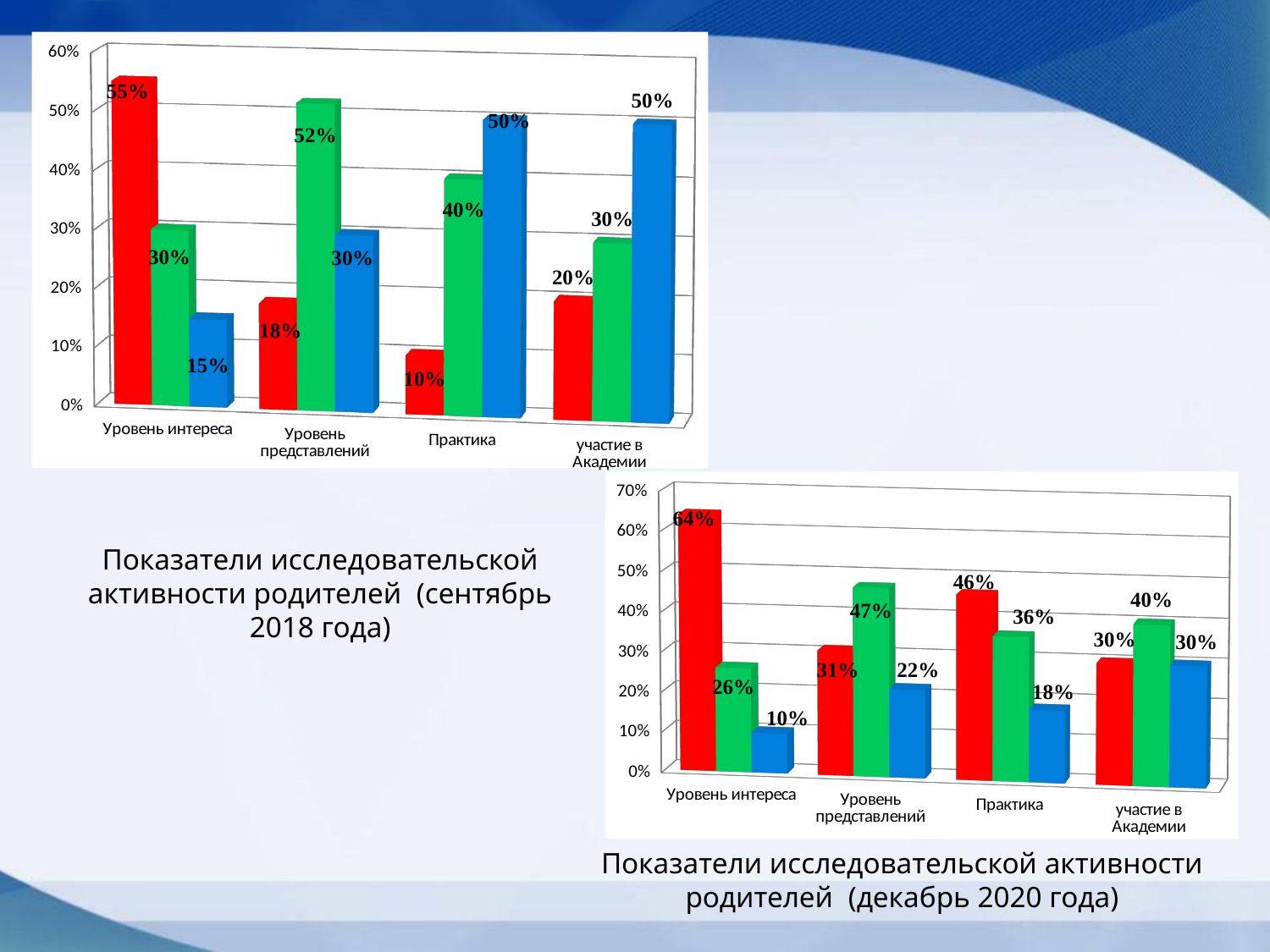
What type of chart is the top chart (September 2018)? bar chart In the bottom chart (December 2020), what is the value of the red bar for Уровень интереса? 64% In the top chart (September 2018), what is the value of the green bar for Уровень представлений? 52% In the bottom chart (December 2020), what is the value of the blue bar for Уровень представлений? 22% In the top chart (September 2018), what is the difference between the green and red bars for Практика? 30% In the top chart (September 2018), what is the value of the blue bar for Практика? 50% How many categories are shown on the x axis of the bottom chart (December 2020)? 4 In the bottom chart (December 2020), what is the difference between the red bars for Уровень интереса and участие в Академии? 34% In the bottom chart (December 2020), which category has the lowest blue bar? Уровень интереса In the bottom chart (December 2020), which is larger for Практика: the red bar or the green bar? the red bar In the top chart (September 2018), what is the value of the red bar for Уровень интереса? 55% In the top chart (September 2018), which category has the lowest red bar? Практика